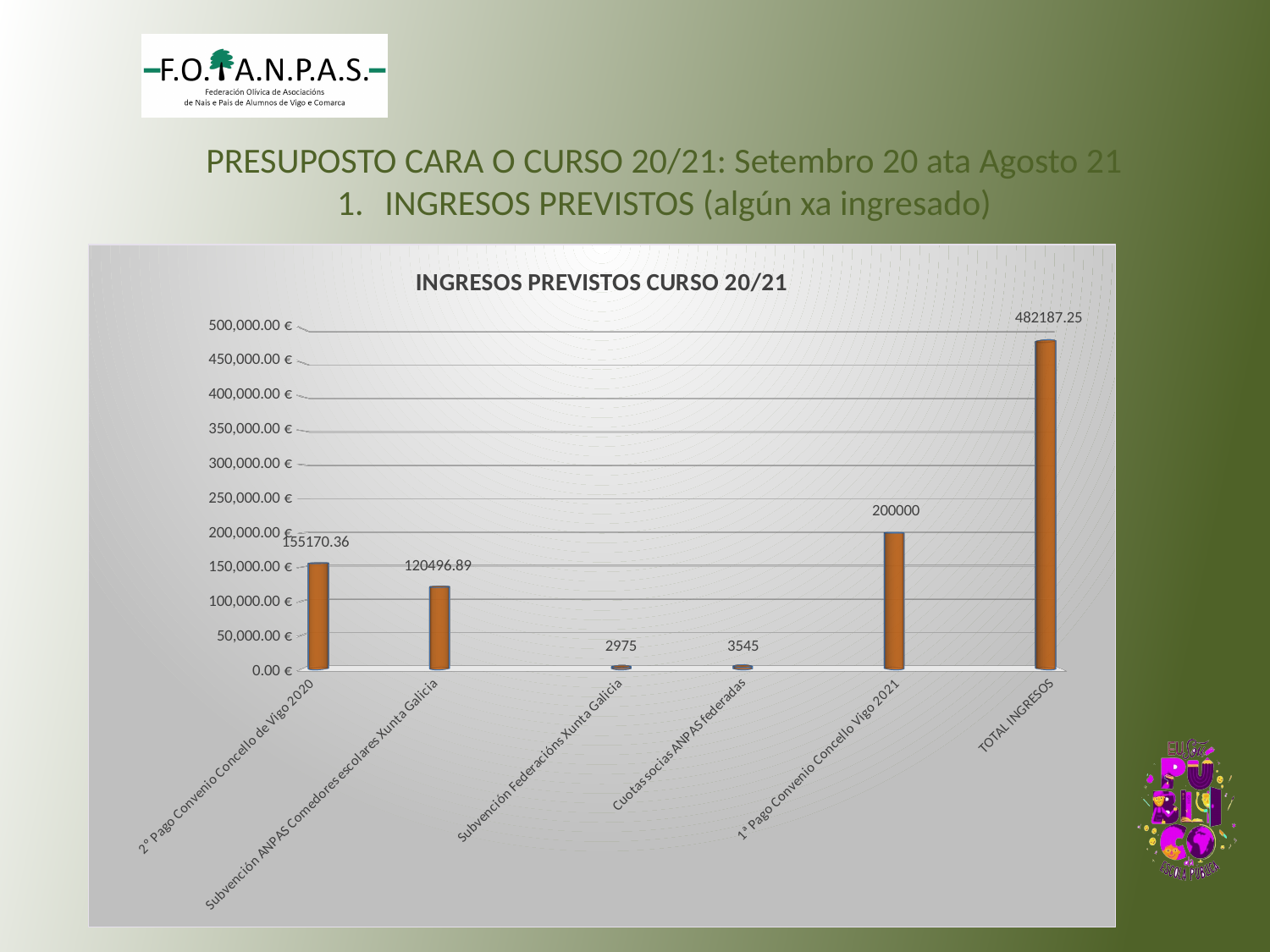
What is the value for 'Subvención ANPAS Comedores escolares Xunta Galicia'? 120496.89 What is the value for 'TOTAL INGRESOS'? 482187.25 What is the difference between the value for '1º Pago Convenio Concello Vigo 2021' and the value for '2º Pago Convenio Concello de Vigo 2020'? 44829.64 What is the value for 'Cuotas socias ANPAS federadas'? 3545 What is the title of the chart? INGRESOS PREVISTOS CURSO 20/21 What kind of chart is shown on the slide? Bar chart What is the value for '1º Pago Convenio Concello Vigo 2021'? 200000 How many categories are plotted in the chart? 6 Which is larger: the value for 'Cuotas socias ANPAS federadas' or the value for 'Subvención Federacións Xunta Galicia'? Cuotas socias ANPAS federadas Which category has the highest value? TOTAL INGRESOS Is the value for '2º Pago Convenio Concello de Vigo 2020' greater or less than 150,000.00 €? greater Which category has the lowest value? Subvención Federacións Xunta Galicia